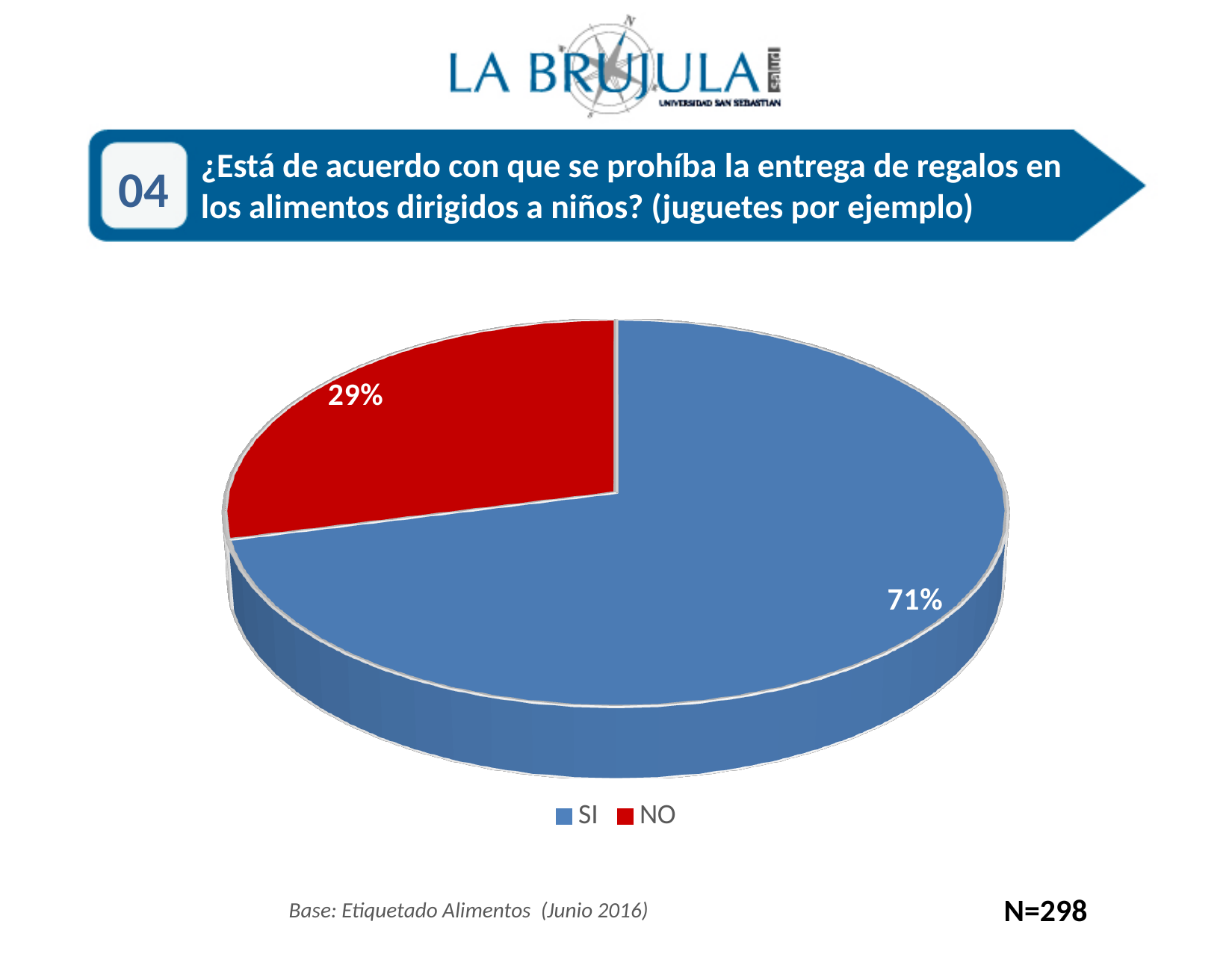
Which is larger, the SI slice or the NO slice? SI How many entries does the legend list? 2 What percentage of respondents answered SI? 71% What is the sample size (N) shown on the slide? N=298 What percentage of respondents answered NO? 29% What colour is the SI slice? Blue What is the difference in percentage points between the SI and NO slices? 42 How many slices does the pie chart have? 2 Which response has the largest share of the pie? SI What kind of chart is shown on the slide? Pie chart Which response has the smallest share of the pie? NO What share of the pie does the NO slice represent? 29%